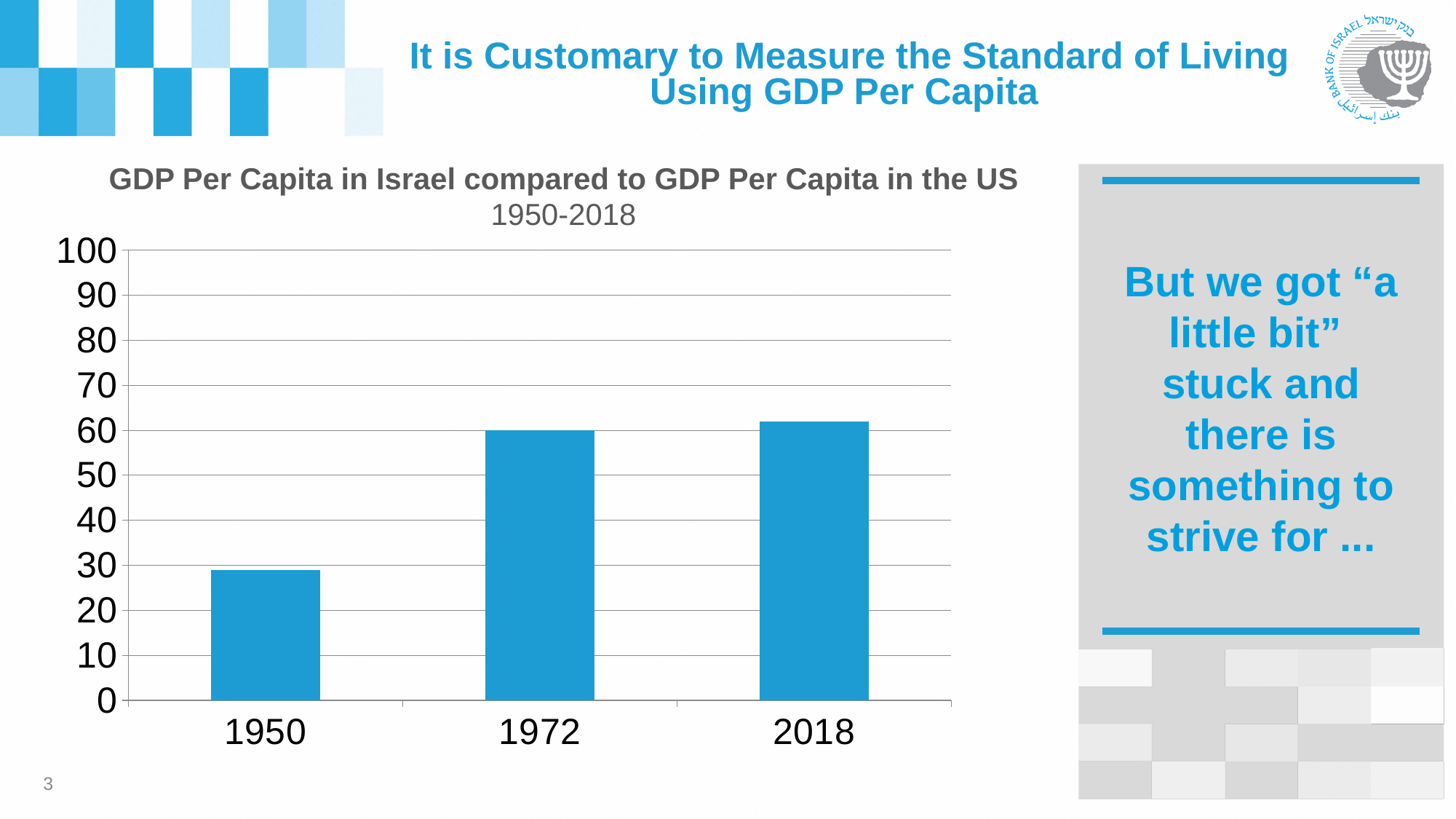
Do the values rise or fall from 1950 to 2018? rise Is the value for 2018 greater or less than 50? greater What period does the chart subtitle state? 1950-2018 What is the title of the chart? GDP Per Capita in Israel compared to GDP Per Capita in the US Is the value for 2018 greater or less than 70? less Is the value for 1950 greater or less than 40? less Which year has the lowest value? 1950 Which is larger, the value for 1950 or the value for 1972? 1972 What is the value for 1972? 60 What kind of chart is shown on the slide? bar chart How many years are shown on the x axis? 3